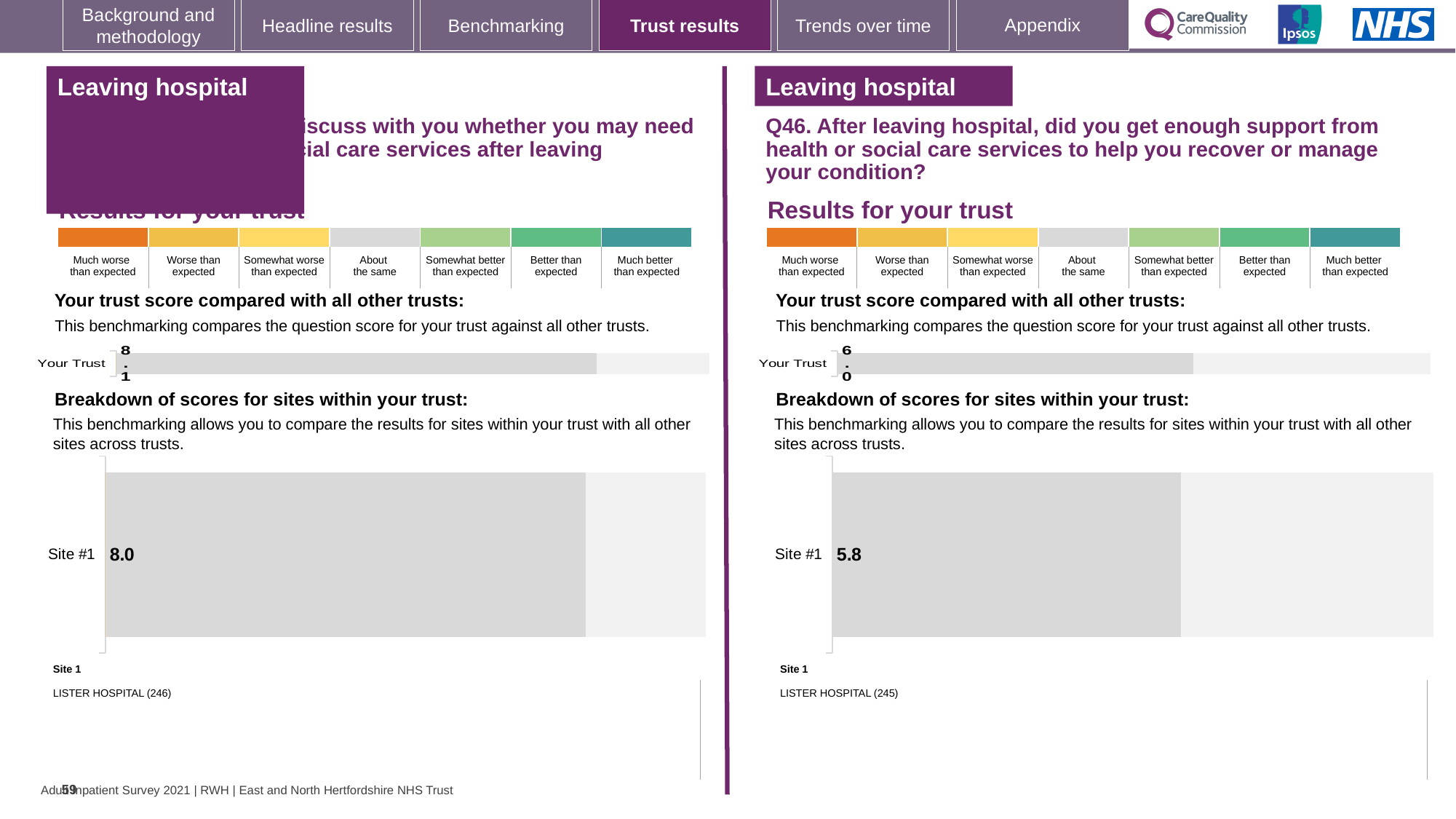
How many sites are shown in the site breakdown chart on the right panel (Q46)? 1 On the left panel, what is the score shown for Site #1 in the site breakdown chart? 8.0 How many sites are shown in the site breakdown chart on the left panel? 1 On the right panel (Q46), what is the difference between the 'Your Trust' score and the Site #1 score? 0.2 What is the difference between the Site #1 score on the left panel (8.0) and the Site #1 score on the right panel (5.8)? 2.2 On the right panel (Q46), what is the score shown for Site #1 in the site breakdown chart? 5.8 On the left panel, what is the score shown for 'Your Trust' in the trust score bar chart? 8.1 Which site name is listed as Site 1 beneath the site breakdown chart on the right panel (Q46)? LISTER HOSPITAL (245) On the right panel (Q46), what is the score shown for 'Your Trust' in the trust score bar chart? 6.0 Which is larger: the 'Your Trust' score on the left panel or the 'Your Trust' score on the right panel (Q46)? Left panel (8.1) What type of chart is used to show the Site #1 score on the right panel (Q46)? Bar chart Which site name is listed as Site 1 beneath the site breakdown chart on the left panel? LISTER HOSPITAL (246)